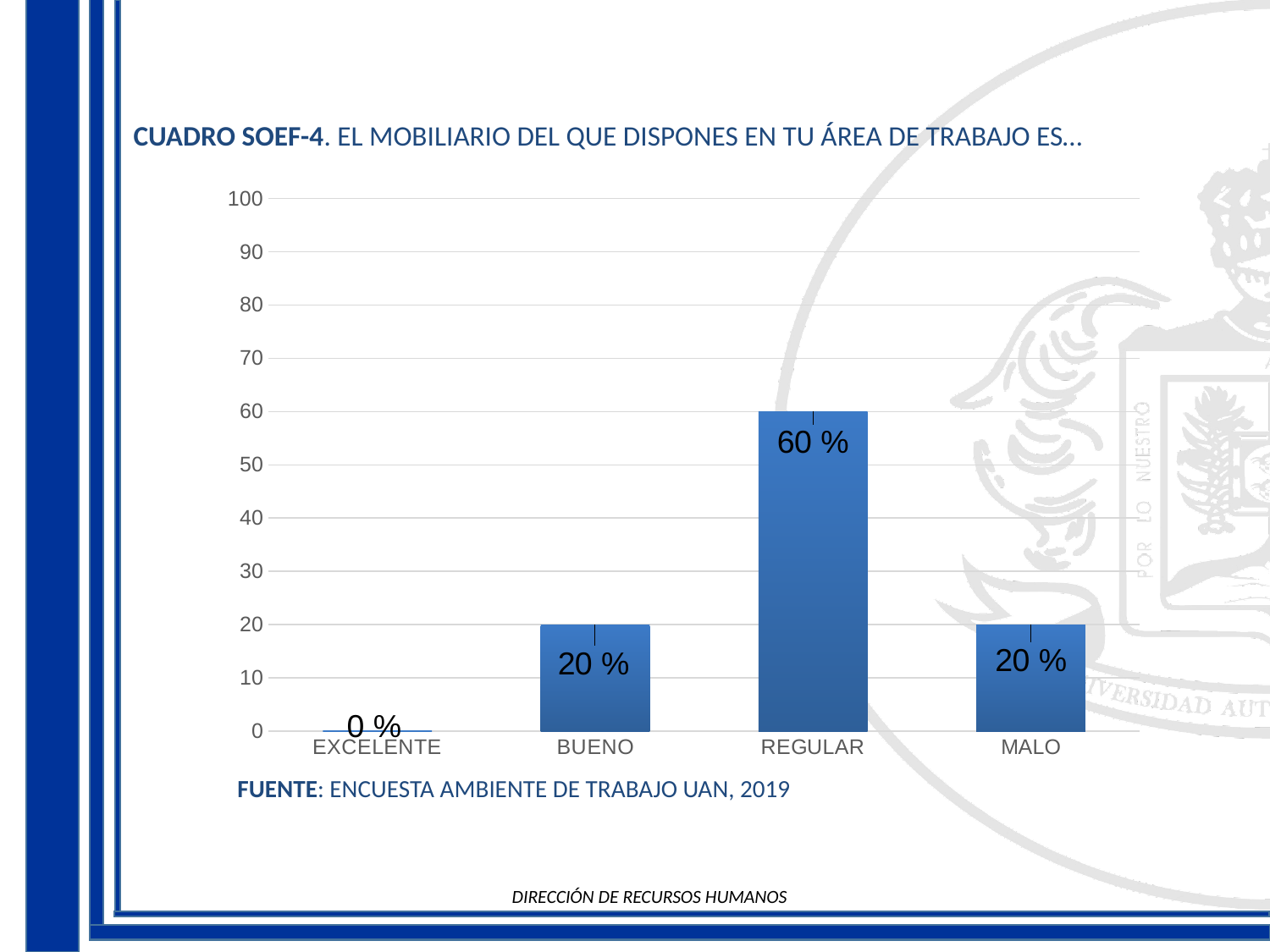
What is the value for EXCELENTE? 0 % How many categories are shown on the x axis? 4 What is the value for MALO? 20 % Which category has the lowest value? EXCELENTE Is the value for REGULAR greater or less than 50? greater What is the source cited below the chart? ENCUESTA AMBIENTE DE TRABAJO UAN, 2019 What is the difference between the values for REGULAR and BUENO? 40 % Which is larger, the value for REGULAR or the value for MALO? REGULAR Which category has the highest value? REGULAR What kind of chart is shown on the slide? bar chart What is the value for BUENO? 20 % What is the value for REGULAR? 60 %